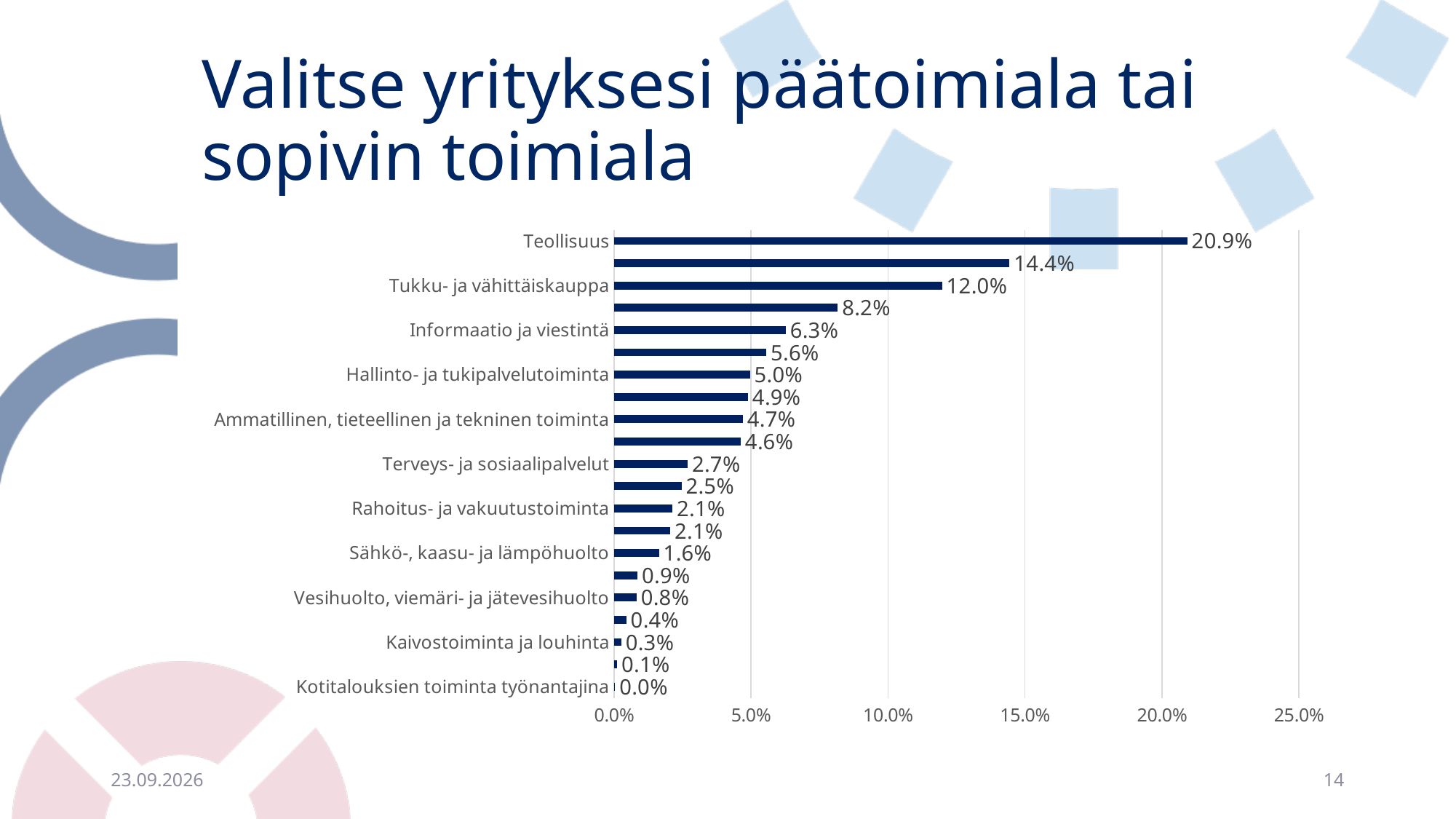
What is the difference between the values for Teollisuus and Tukku- ja vähittäiskauppa? 8.9% What is the value for Terveys- ja sosiaalipalvelut? 2.7% What is the value for Tukku- ja vähittäiskauppa? 12.0% What is the value for Kaivostoiminta ja louhinta? 0.3% Which category has the lowest value? Kotitalouksien toiminta työnantajina How many bars are plotted in the chart? 21 What is the value for Teollisuus? 20.9% What kind of chart is shown on the slide? Bar chart Which category has the highest value? Teollisuus Is the value for Teollisuus greater or less than 20.0%? greater Which is larger, the value for Hallinto- ja tukipalvelutoiminta or the value for Rahoitus- ja vakuutustoiminta? Hallinto- ja tukipalvelutoiminta What is the value for Informaatio ja viestintä? 6.3%